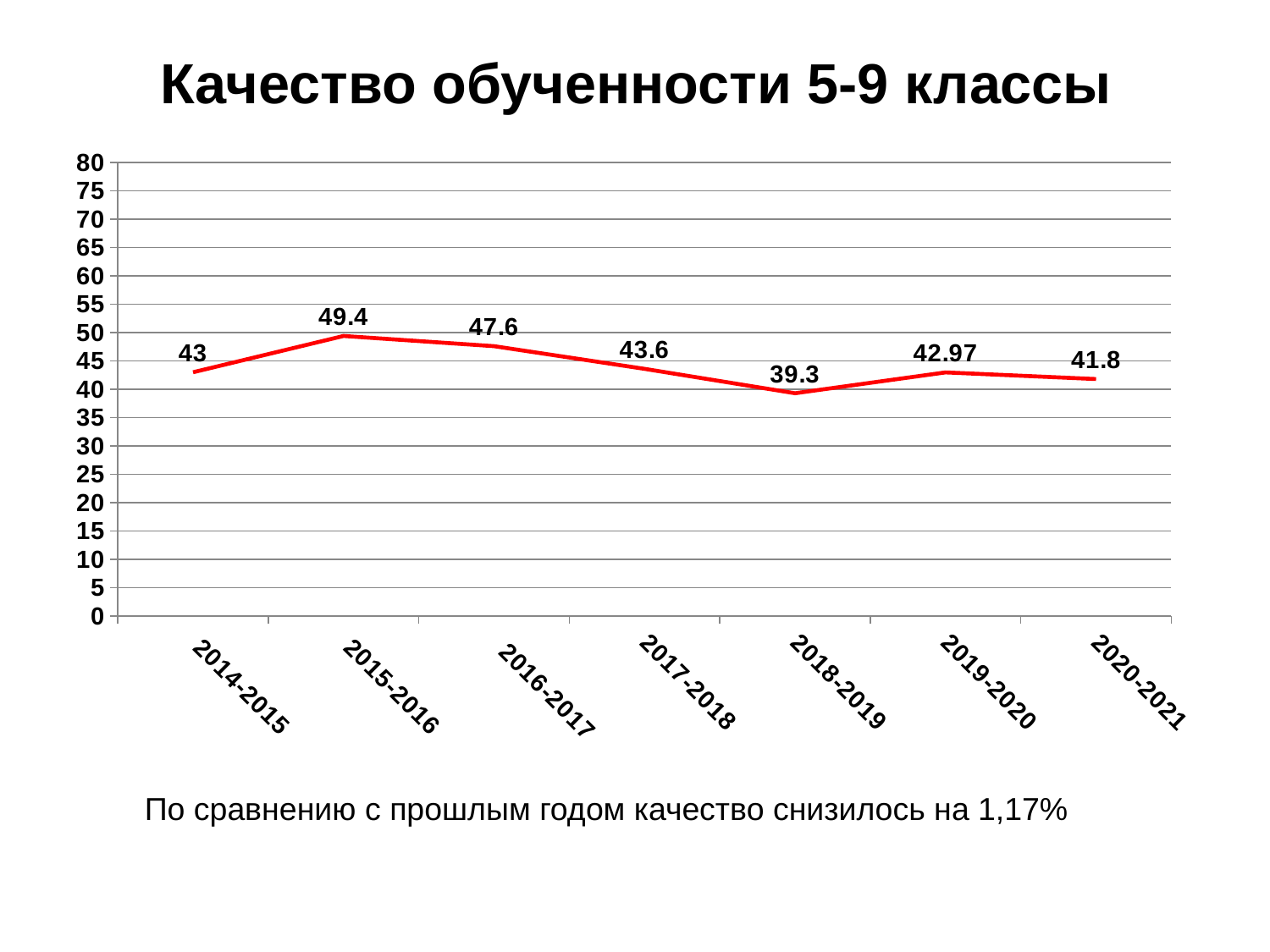
How many data points are plotted on the chart? 7 What is the value for 2019-2020? 42.97 What is the value for 2018-2019? 39.3 Which year has the lowest value? 2018-2019 Which is larger, the value for 2014-2015 or the value for 2020-2021? 2014-2015 What is the difference between the values for 2016-2017 and 2017-2018? 4 What is the value for 2015-2016? 49.4 What is the title of the chart? Качество обученности 5-9 классы What is the difference between the values for 2015-2016 and 2018-2019? 10.1 What kind of chart is shown on the slide? line chart Is the value for 2016-2017 greater or less than 45? greater Which year has the highest value? 2015-2016